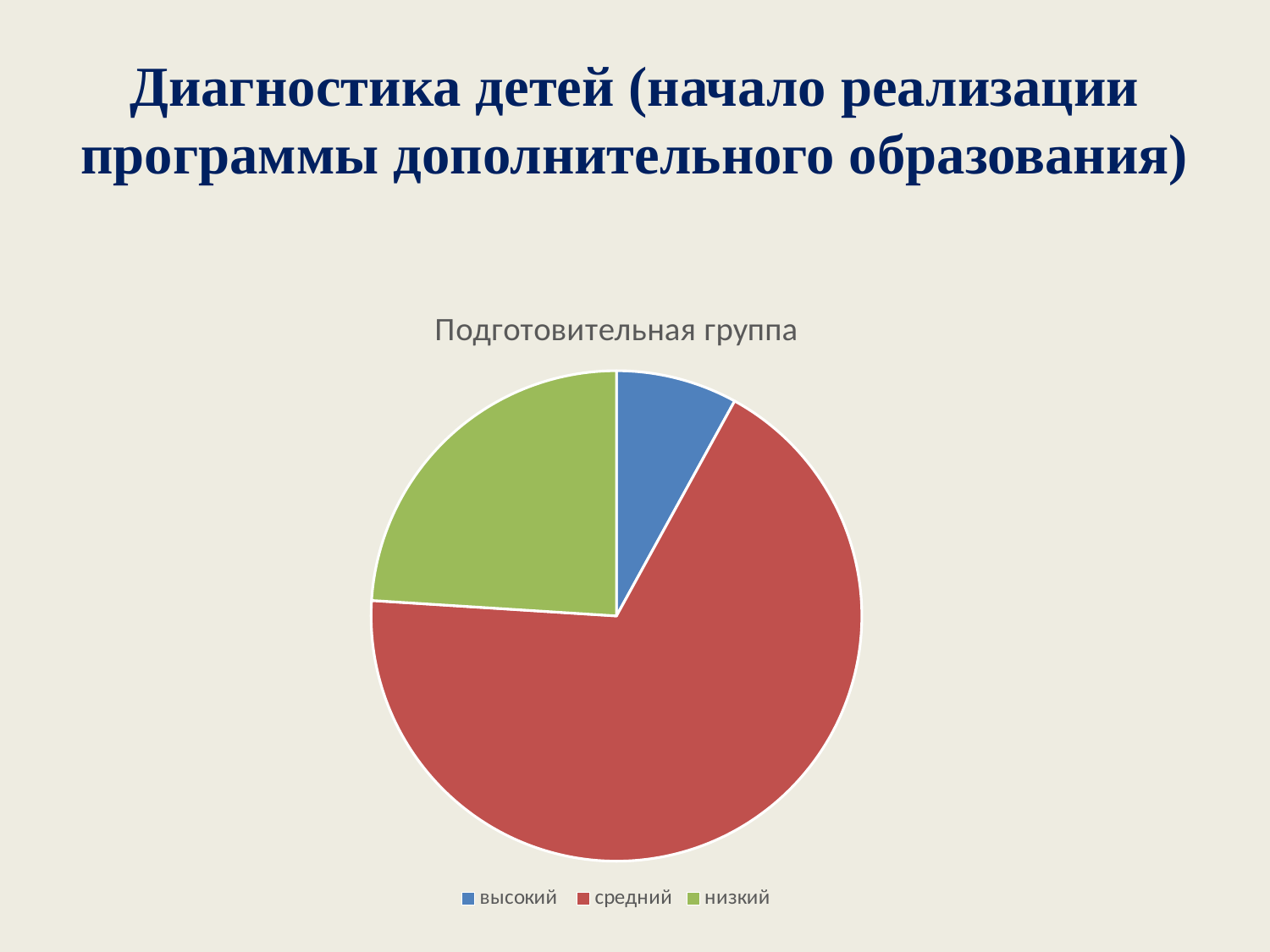
What kind of chart is shown on the slide? pie chart What is the title of the chart? Подготовительная группа Which category has the smallest slice of the pie? высокий How many entries does the legend list? 3 How many slices does the pie chart have? 3 Which slice is larger, средний or низкий? средний Which category has the largest slice of the pie? средний Which slice is larger, низкий or высокий? низкий What colour is the slice for средний? red